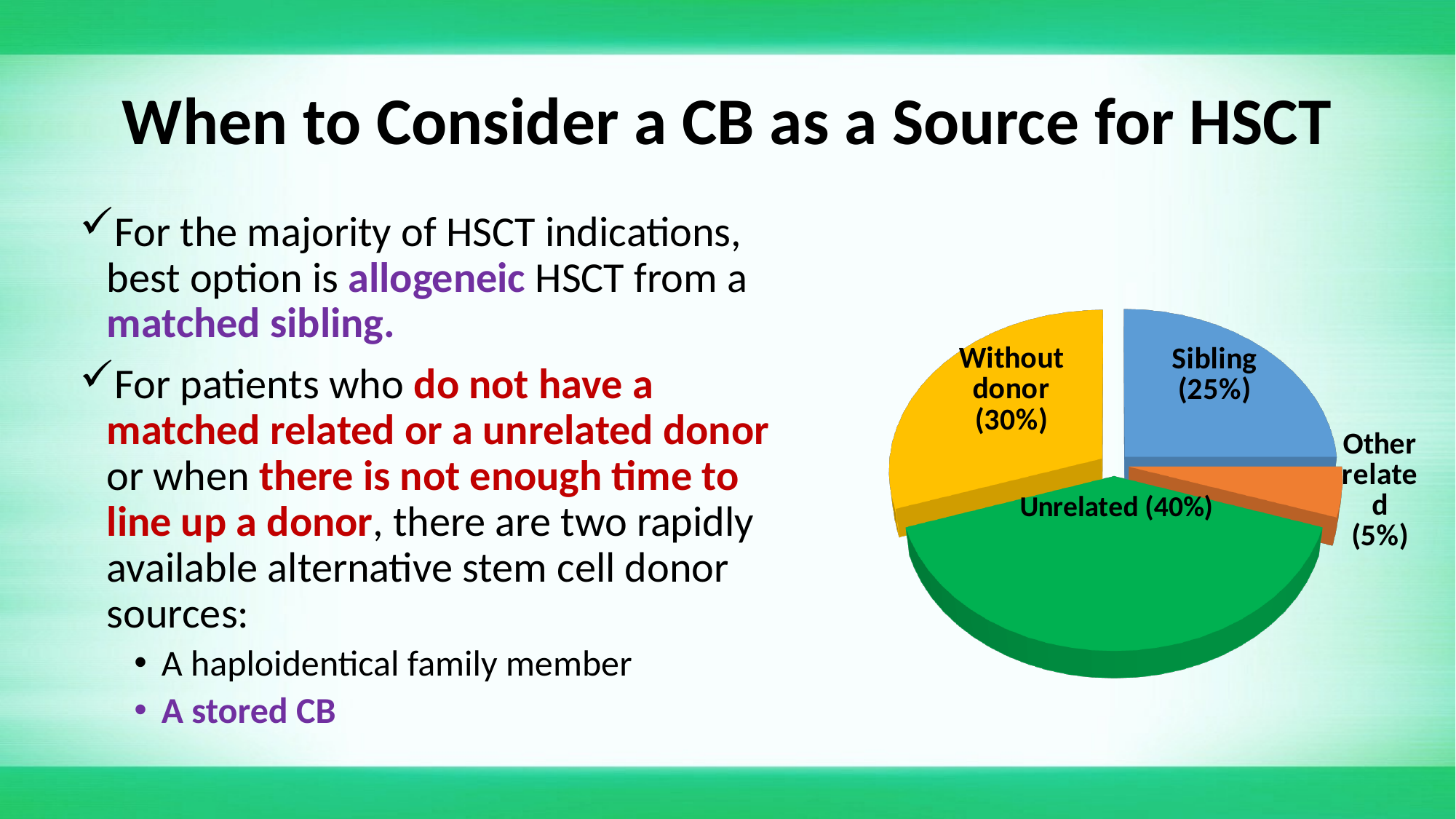
Which is larger, the Without donor slice or the Sibling slice? Without donor How many slices does the pie chart have? 4 What share of the pie does the Unrelated slice represent? 40% What share of the pie does the Other related slice represent? 5% What share of the pie does the Without donor slice represent? 30% Which slice of the pie chart is the largest? Unrelated Which slice of the pie chart is the smallest? Other related What kind of chart is shown on the slide? pie chart What is the difference in percentage points between the Without donor and Other related slices? 25 What is the difference in percentage points between the Unrelated and Sibling slices? 15 What colour is the Unrelated slice of the pie chart? green